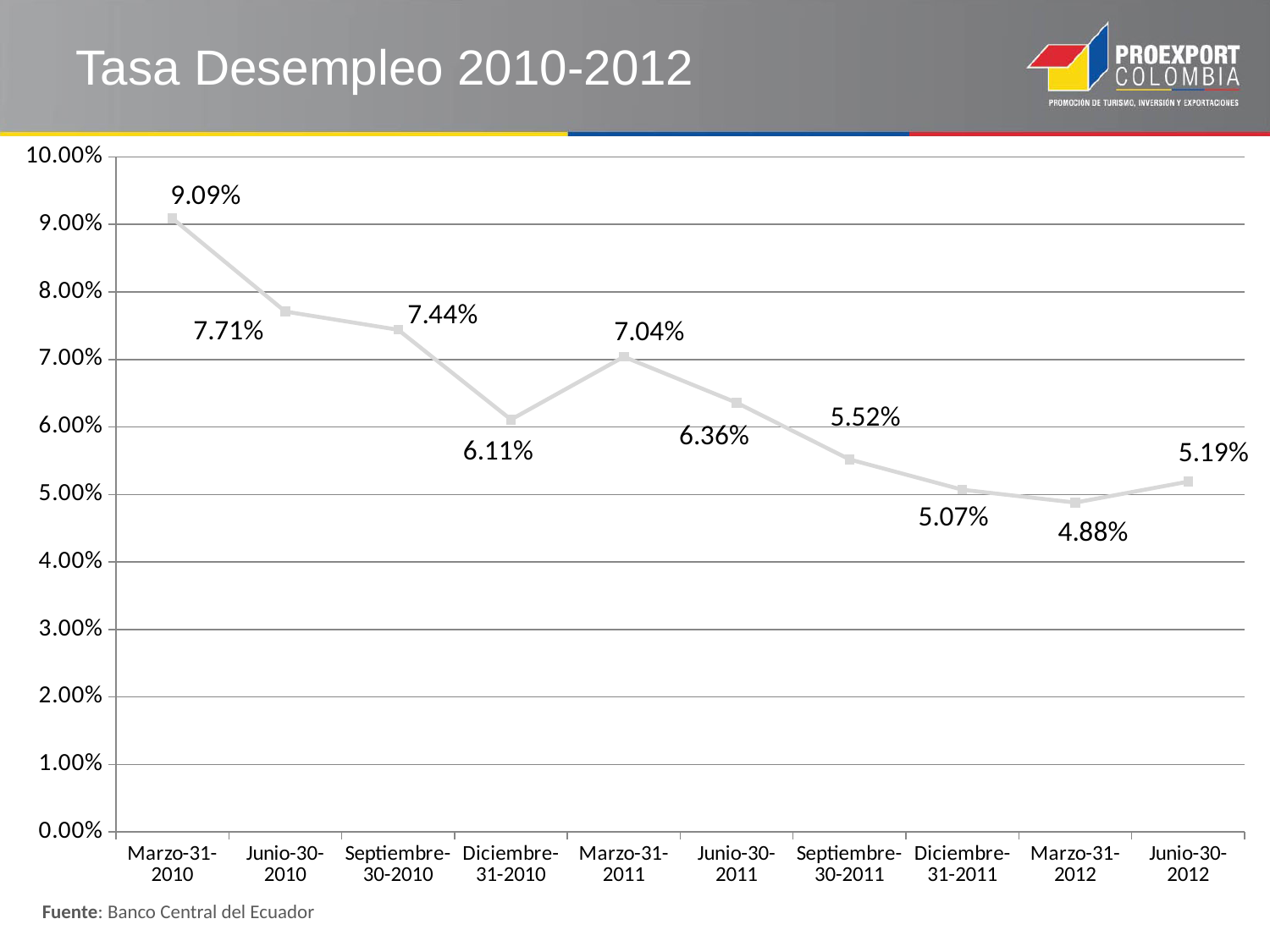
Do the values generally rise or fall from Marzo-31-2010 to Marzo-31-2012? fall Which date has the lowest unemployment rate? Marzo-31-2012 Which date has the highest unemployment rate? Marzo-31-2010 What is the value for Diciembre-31-2010? 6.11% What is the title of the chart? Tasa Desempleo 2010-2012 Is the value for Septiembre-30-2011 greater or less than 6.00%? less What is the difference between the values for Marzo-31-2010 and Junio-30-2010? 1.38% What kind of chart is shown on the slide? line chart What is the unemployment rate for Marzo-31-2010? 9.09% Which is larger, the value for Diciembre-31-2010 or Marzo-31-2011? Marzo-31-2011 How many data points are plotted on the chart? 10 What is the value for Junio-30-2012? 5.19%